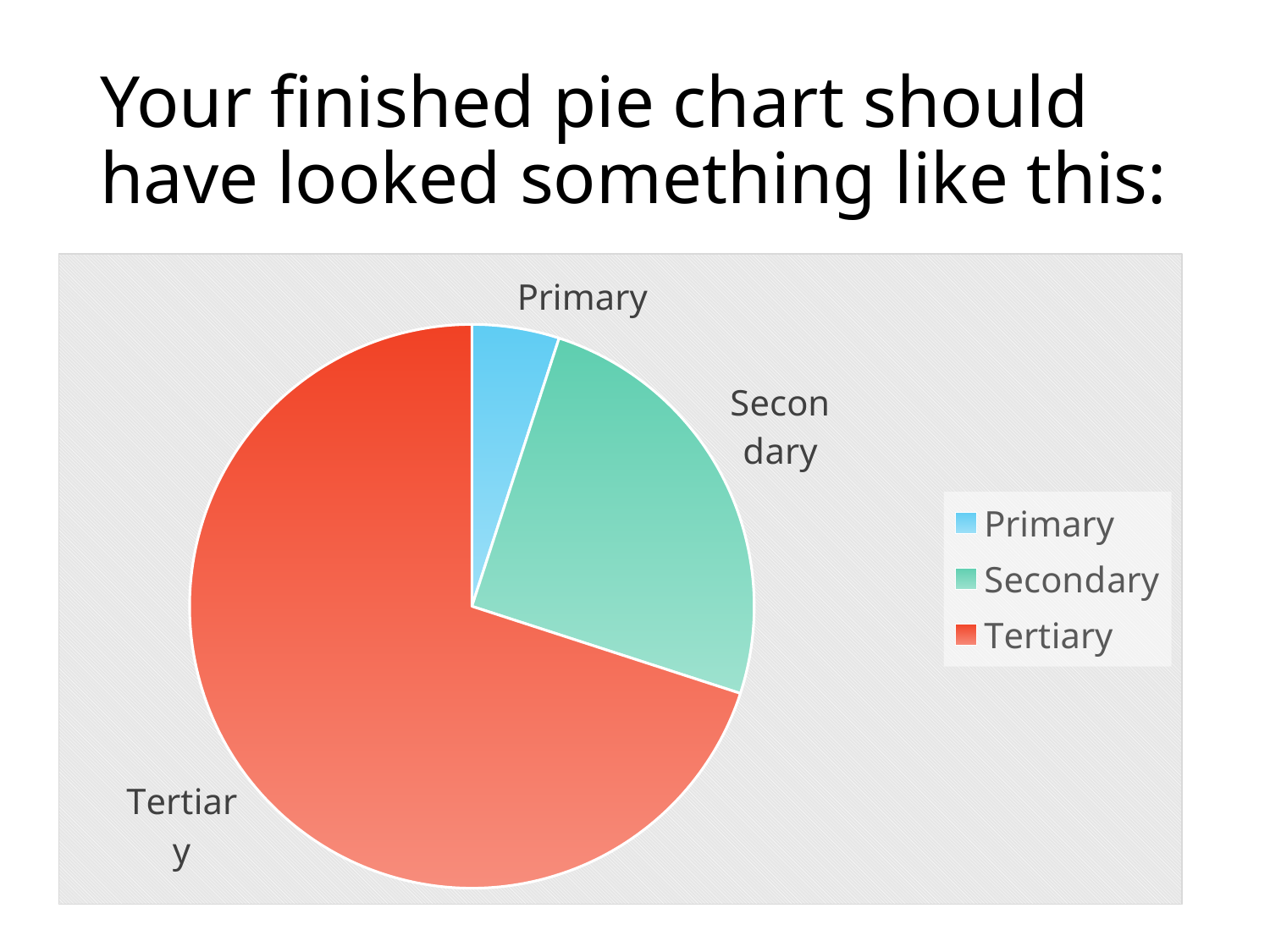
Does the Tertiary slice take up more or less than half of the pie chart? more Which slice is larger in the pie chart, Secondary or Tertiary? Tertiary Which slice is smaller in the pie chart, Primary or Tertiary? Primary Which category has the largest slice of the pie chart? Tertiary What colour is the Tertiary slice in the pie chart? red How many slices does the pie chart have? 3 Which category has the smallest slice of the pie chart? Primary What kind of chart is shown on the slide? pie chart Which category is shown in blue in the pie chart? Primary How many entries does the legend of the pie chart list? 3